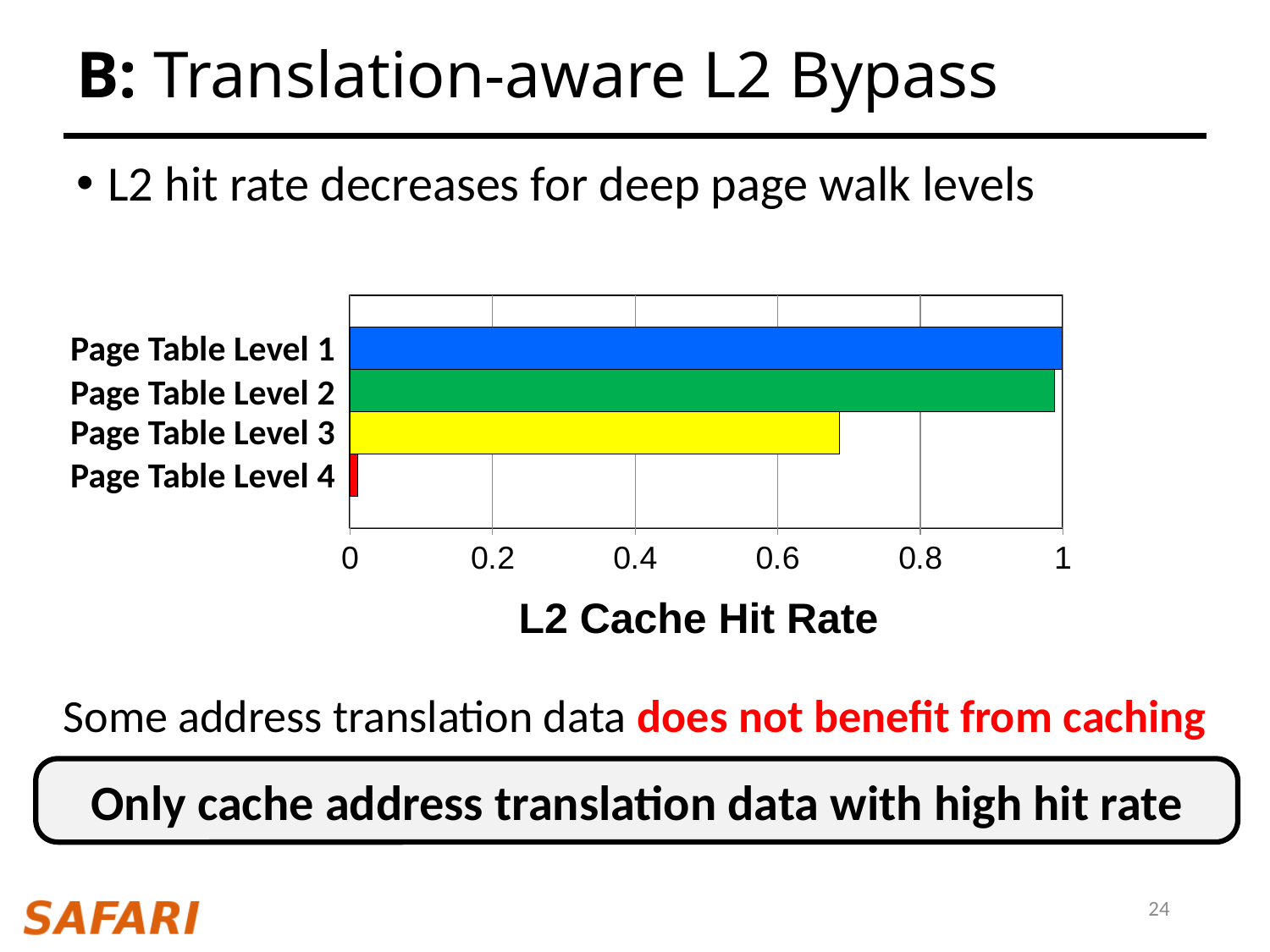
Which page table level has the lowest L2 cache hit rate? Page Table Level 4 Which has a higher L2 cache hit rate, Page Table Level 3 or Page Table Level 4? Page Table Level 3 Is the L2 cache hit rate for Page Table Level 2 greater or less than 0.8? greater What is the title of the horizontal axis of the chart? L2 Cache Hit Rate What colour is the bar for Page Table Level 4? red Does the L2 cache hit rate rise or fall as the page table level goes from Level 1 to Level 4? fall Is the L2 cache hit rate for Page Table Level 3 greater or less than 0.6? greater How many page table levels are plotted in the chart? 4 Is the L2 cache hit rate for Page Table Level 3 greater or less than 0.8? less Which has a higher L2 cache hit rate, Page Table Level 2 or Page Table Level 3? Page Table Level 2 What kind of chart is shown on the slide? bar chart